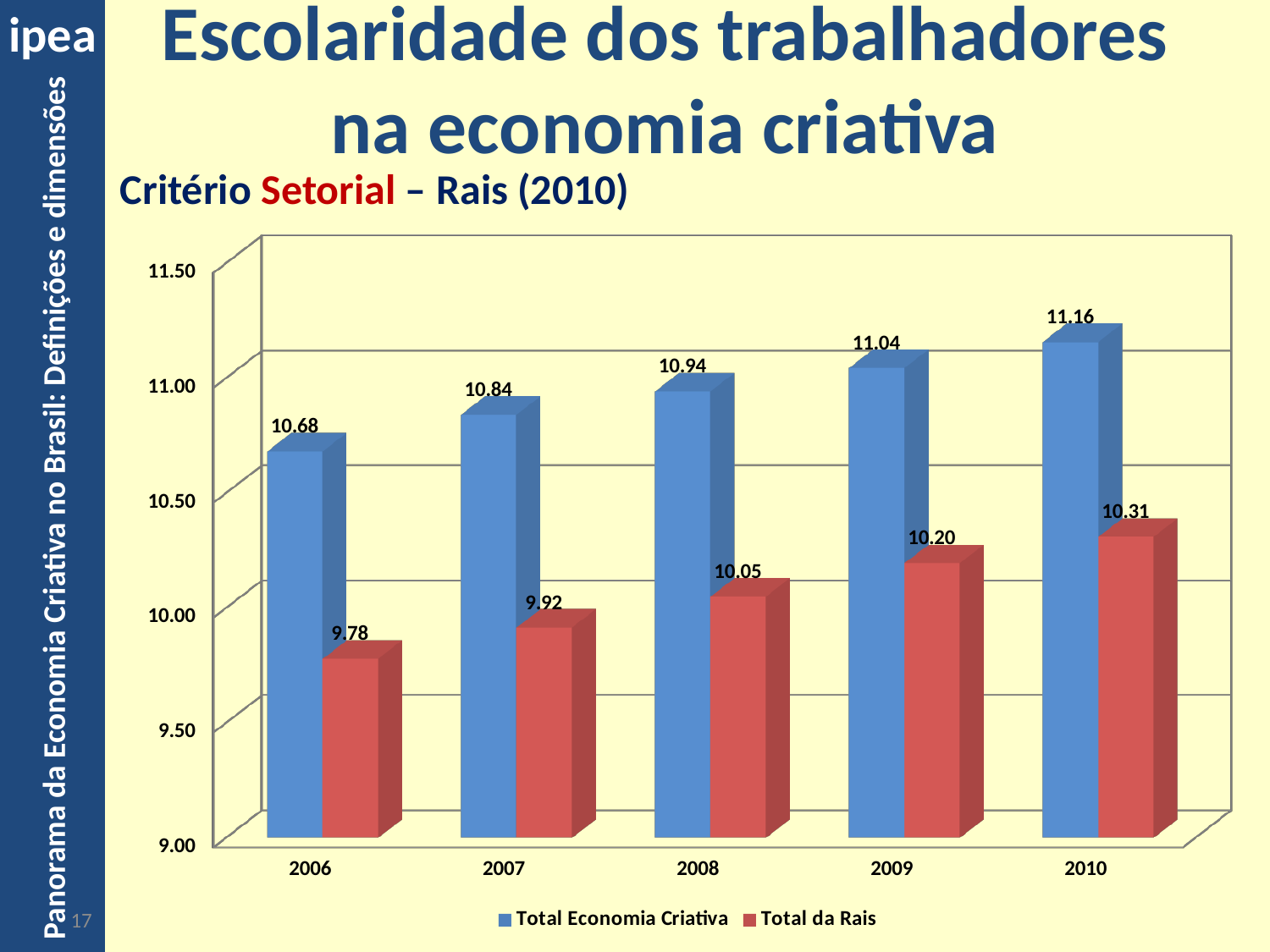
What is the value for Total Economia Criativa in 2006? 10.68 What is the value for Total da Rais in 2010? 10.31 What is the difference between Total Economia Criativa and Total da Rais in 2010? 0.85 What kind of chart is shown on the slide? Bar chart What is the value for Total da Rais in 2008? 10.05 Which is larger in 2007: Total Economia Criativa or Total da Rais? Total Economia Criativa How many series does the legend list? 2 In which year is Total da Rais lowest? 2006 In which year is Total Economia Criativa highest? 2010 Do the values for Total da Rais rise or fall from 2006 to 2010? Rise How many years are shown on the x axis? 5 Which colour represents Total da Rais in the chart? Red